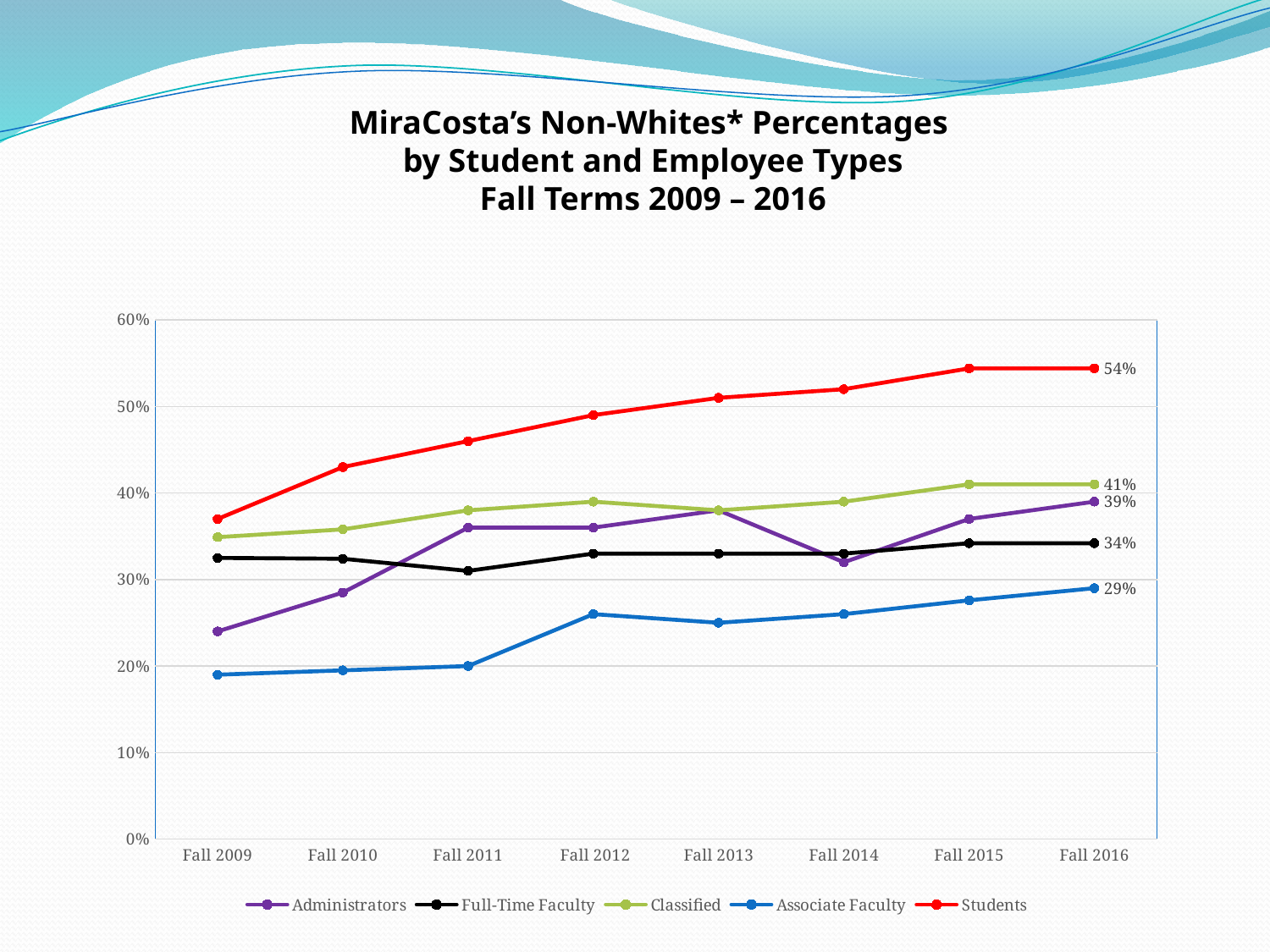
What is the difference between the Students and Associate Faculty values in Fall 2016? 25% Which series has the highest value in Fall 2016? Students How many series does the legend list? 5 In Fall 2016, which is larger: the Administrators value or the Full-Time Faculty value? Administrators What is the value for Associate Faculty in Fall 2016? 29% What type of chart is shown on the slide? Line chart How many fall terms are plotted along the x axis? 8 Is the value for Students in Fall 2009 greater or less than 40%? less What is the value for Students in Fall 2016? 54% Which series has the lowest value in Fall 2016? Associate Faculty Does the Students line rise or fall from Fall 2009 to Fall 2016? Rise What is the value for Classified in Fall 2016? 41%